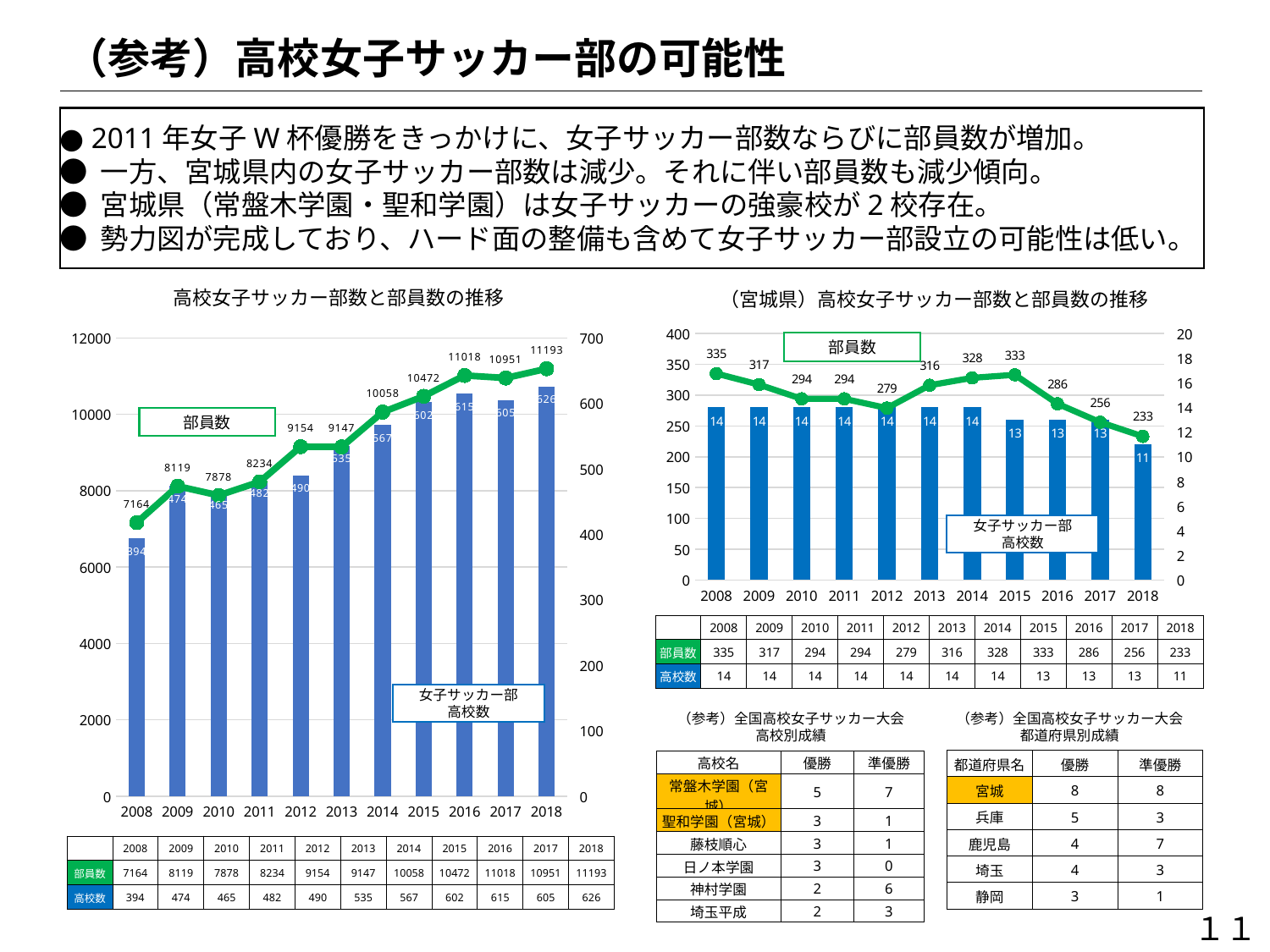
In the left chart (高校女子サッカー部数と部員数の推移), what is the 部員数 value for 2018? 11193 In the left chart (高校女子サッカー部数と部員数の推移), how many years are plotted on the x axis? 11 In the left chart (高校女子サッカー部数と部員数の推移), which series is drawn as a line rather than bars? 部員数 In the right chart ((宮城県) 高校女子サッカー部数と部員数の推移), does the 部員数 rise or fall from 2015 to 2018? fall In the right chart ((宮城県) 高校女子サッカー部数と部員数の推移), which year has the lowest 部員数? 2018 In the left chart (高校女子サッカー部数と部員数の推移), what is the 高校数 value for 2008? 394 In the right chart ((宮城県) 高校女子サッカー部数と部員数の推移), how many data series are shown? 2 In the right chart ((宮城県) 高校女子サッカー部数と部員数の推移), what is the 高校数 value for 2018? 11 In the left chart (高校女子サッカー部数と部員数の推移), which year has the highest 部員数? 2018 In the left chart (高校女子サッカー部数と部員数の推移), what is the difference between the 高校数 for 2018 and for 2008? 232 In the left chart (高校女子サッカー部数と部員数の推移), which is larger, the 高校数 for 2016 or for 2017? 2016 In the right chart ((宮城県) 高校女子サッカー部数と部員数の推移), what is the difference between the 部員数 for 2008 and for 2018? 102